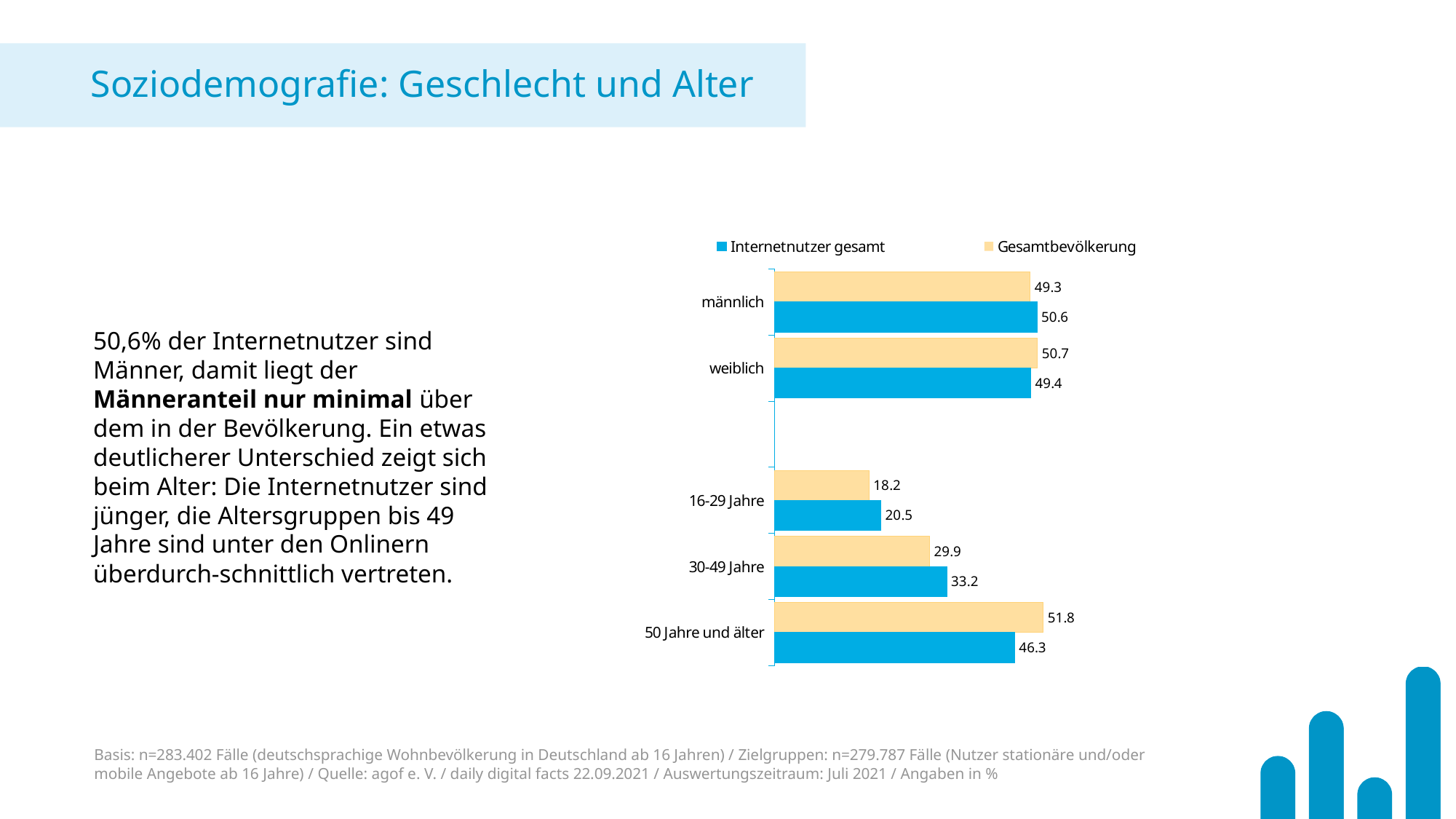
What is the difference between the Gesamtbevölkerung and Internetnutzer gesamt values for 50 Jahre und älter? 5.5 What is the value for Gesamtbevölkerung in the 16-29 Jahre category? 18.2 What is the value for Internetnutzer gesamt in the männlich category? 50.6 What is the value for Internetnutzer gesamt in the 50 Jahre und älter category? 46.3 What kind of chart is shown on the slide? Bar chart How many categories are shown on the chart? 5 Which category has the lowest value for Gesamtbevölkerung? 16-29 Jahre How many series does the legend list? 2 What is the value for Gesamtbevölkerung in the weiblich category? 50.7 For 16-29 Jahre, which is larger: Internetnutzer gesamt or Gesamtbevölkerung? Internetnutzer gesamt Among the age groups, which category has the highest value for Internetnutzer gesamt? 50 Jahre und älter What is the difference between the Internetnutzer gesamt and Gesamtbevölkerung values for 30-49 Jahre? 3.3